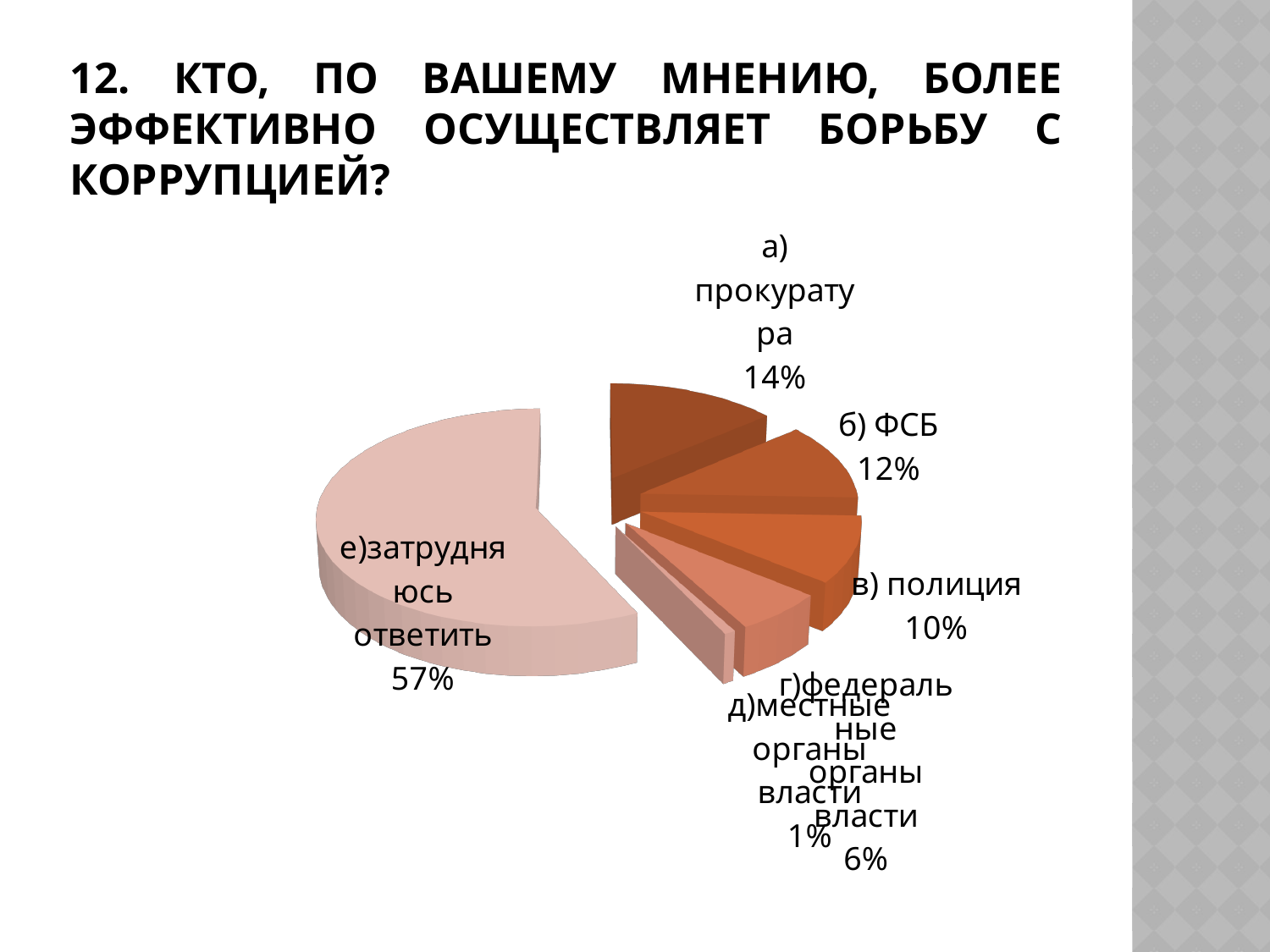
What share of respondents answered «б) ФСБ»? 12% What share of respondents answered «а) прокуратура»? 14% What share of respondents answered «е) затрудняюсь ответить»? 57% What share of respondents answered «г) федеральные органы власти»? 6% What is the difference in percentage points between «а) прокуратура» and «б) ФСБ»? 2% Which answer option has the smallest slice of the pie? д) местные органы власти What is the difference in percentage points between «е) затрудняюсь ответить» and «а) прокуратура»? 43% What share of respondents answered «в) полиция»? 10% How many slices does the pie chart have? 6 Which answer option has the largest slice of the pie? е) затрудняюсь ответить Which is larger: the share for «в) полиция» or the share for «г) федеральные органы власти»? в) полиция What kind of chart is shown on the slide? pie chart